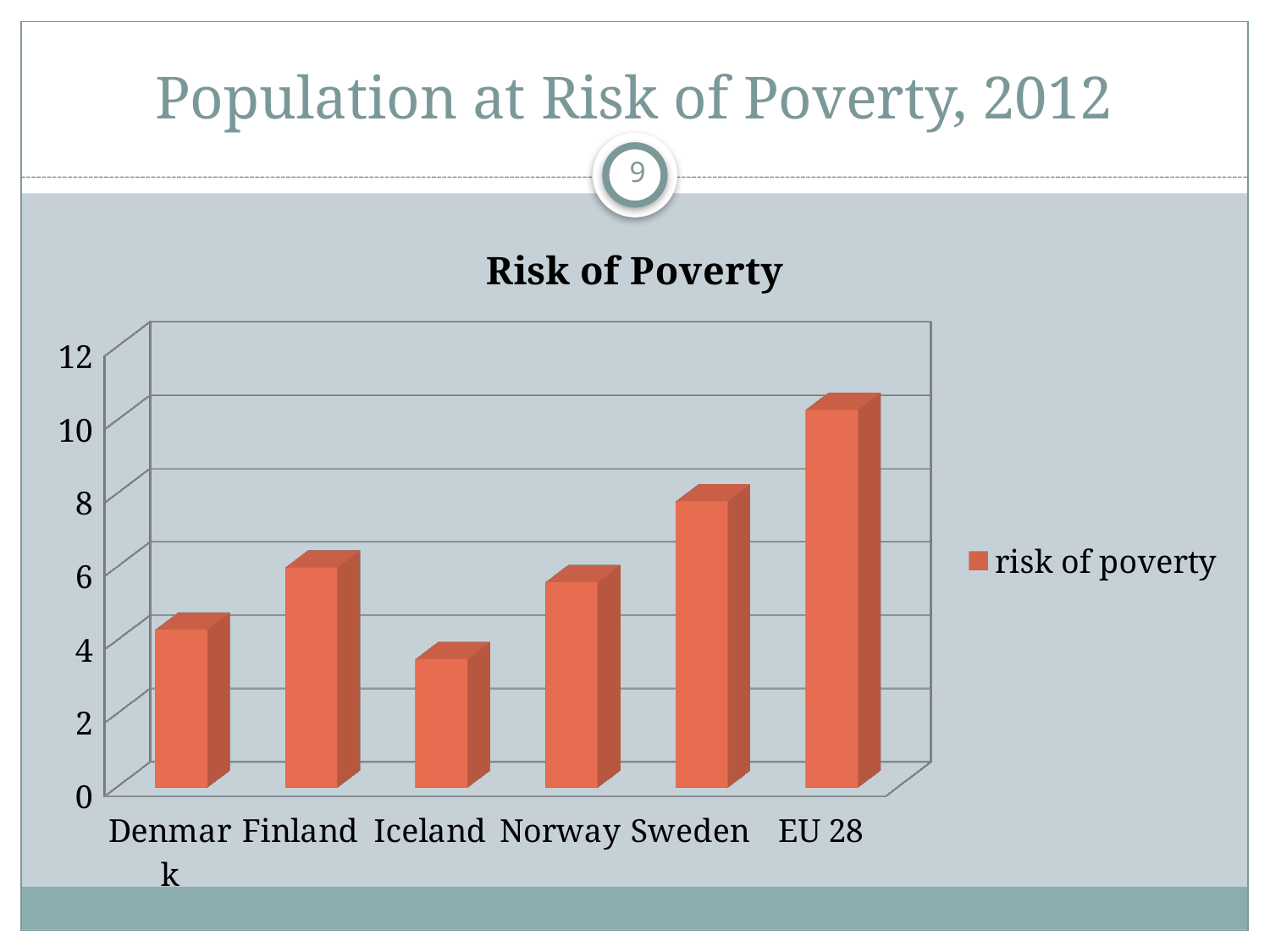
Is the value for Denmark greater or less than 6? less How many series does the legend list? 1 What kind of chart is shown on the slide? bar chart Which category has the lowest value in the Risk of Poverty chart? Iceland Which is larger, the value for Sweden or the value for Finland? Sweden Is the value for EU 28 greater or less than 8? greater What is the title of the chart? Risk of Poverty Which is larger, the value for Norway or the value for Iceland? Norway Which category has the highest value in the Risk of Poverty chart? EU 28 Is the value for Iceland greater or less than 6? less How many categories are shown on the x axis of the chart? 6